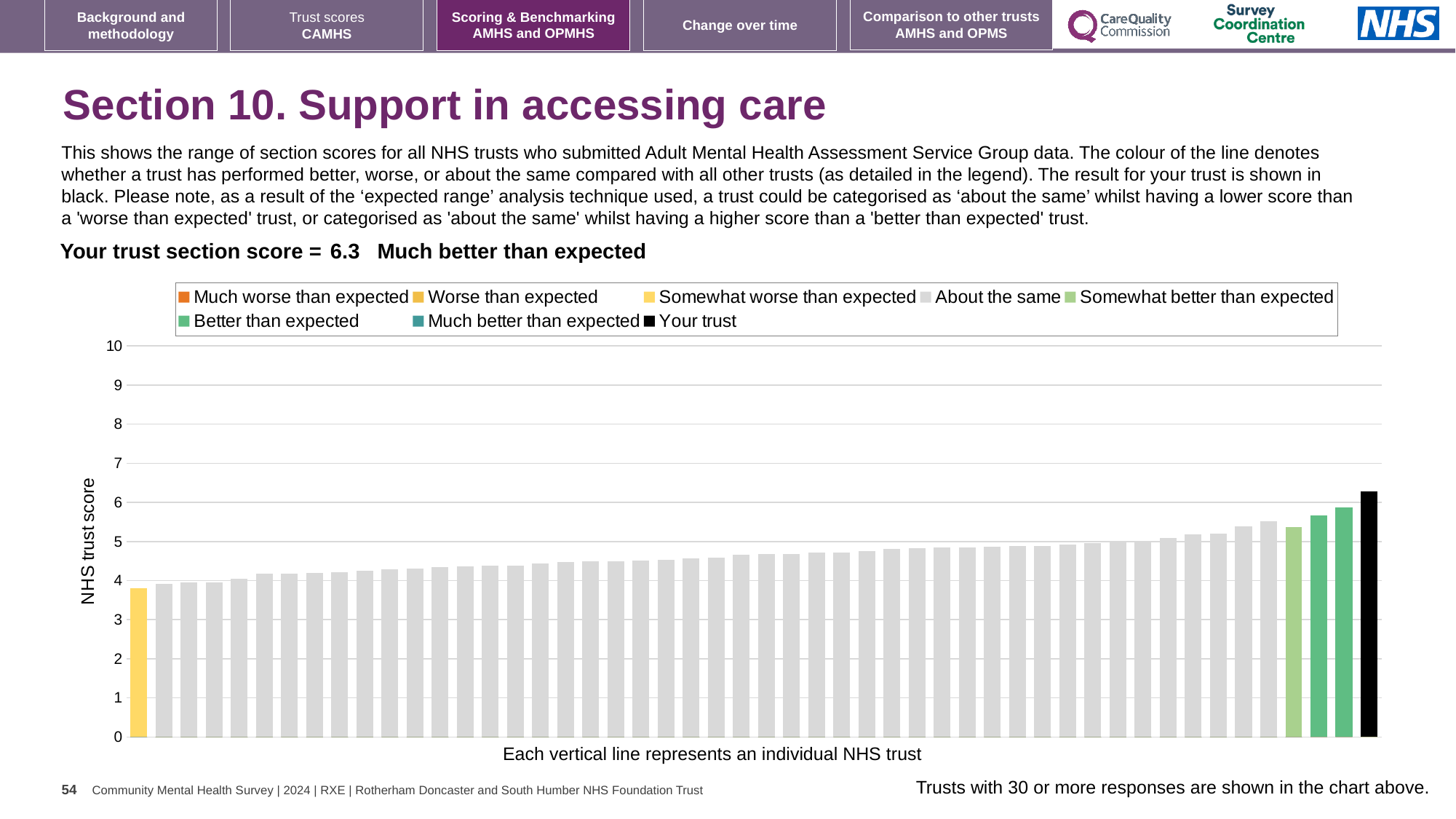
Which legend category does the lowest bar in the chart belong to? Somewhat worse than expected Which is taller, the black 'Your trust' bar or the yellow bar at the far left? The black 'Your trust' bar Is the value of the black 'Your trust' bar greater or less than 6? greater Which bar in the chart is the highest? The black 'Your trust' bar What kind of chart is shown on the slide? Bar chart How many entries does the chart legend list? 8 Is the value of the leftmost (yellow) bar greater or less than 5? less Which category does the slide assign to your trust's section score of 6.3? Much better than expected Do the bar values rise or fall from left to right along the x axis? Rise How many bars in the chart are coloured yellow? 1 What is the section score for your trust shown on the slide? 6.3 What is the label on the vertical axis of the chart? NHS trust score